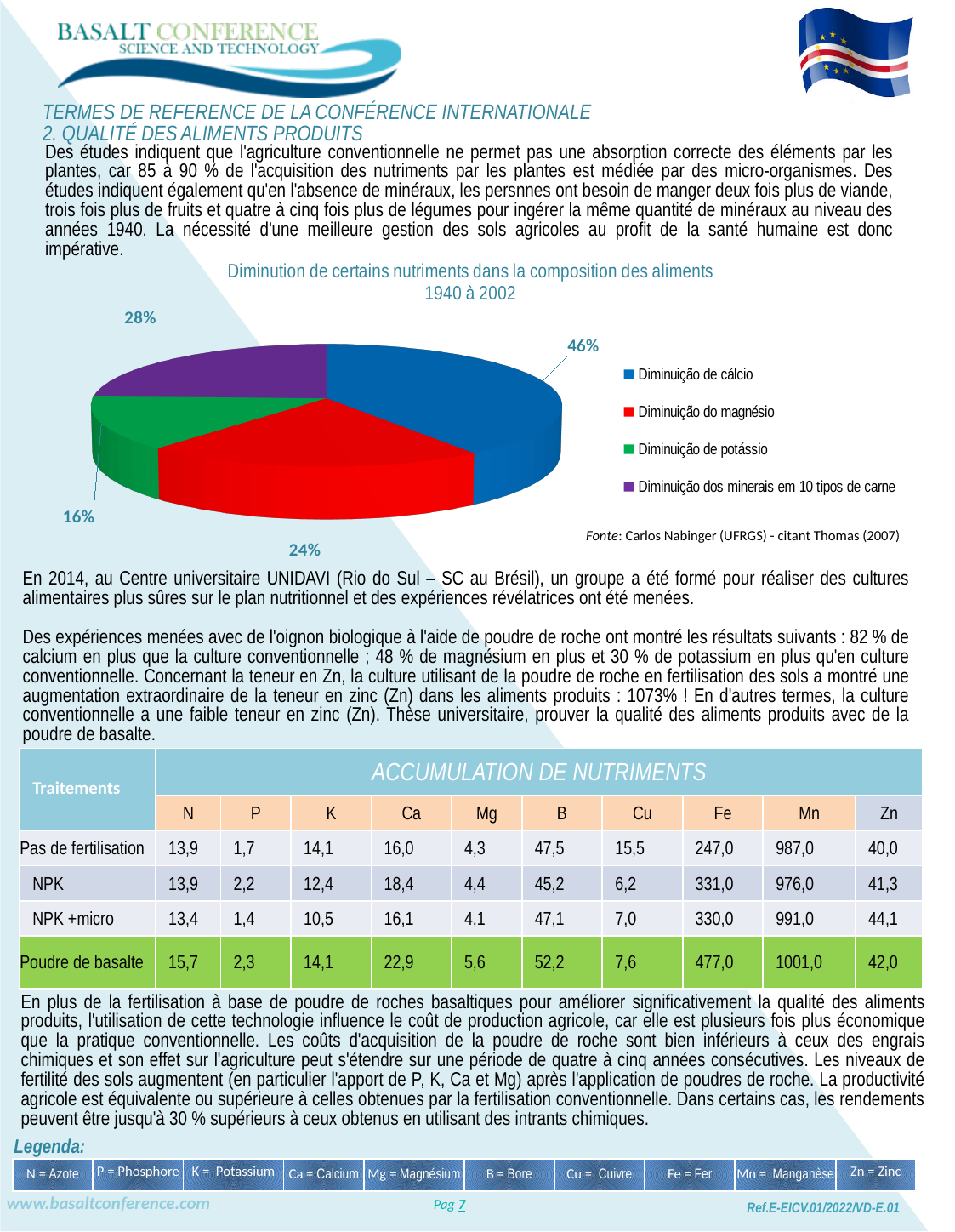
What is the value shown for "Diminuição de cálcio" in the pie chart? 46% How many slices does the pie chart have? 4 What is the difference between the values for "Diminuição de cálcio" and "Diminuição do magnésio"? 22% What is the value shown for "Diminuição do magnésio" in the pie chart? 24% What is the value shown for "Diminuição de potássio" in the pie chart? 16% How many entries does the legend of the pie chart list? 4 Which category has the largest slice in the pie chart? Diminuição de cálcio What colour is the slice for "Diminuição de potássio" in the pie chart? green What kind of chart is shown on the slide? pie chart What is the value shown for "Diminuição dos minerais em 10 tipos de carne" in the pie chart? 28% Which category has the smallest slice in the pie chart? Diminuição de potássio Which is larger: the value for "Diminuição dos minerais em 10 tipos de carne" or the value for "Diminuição do magnésio"? Diminuição dos minerais em 10 tipos de carne